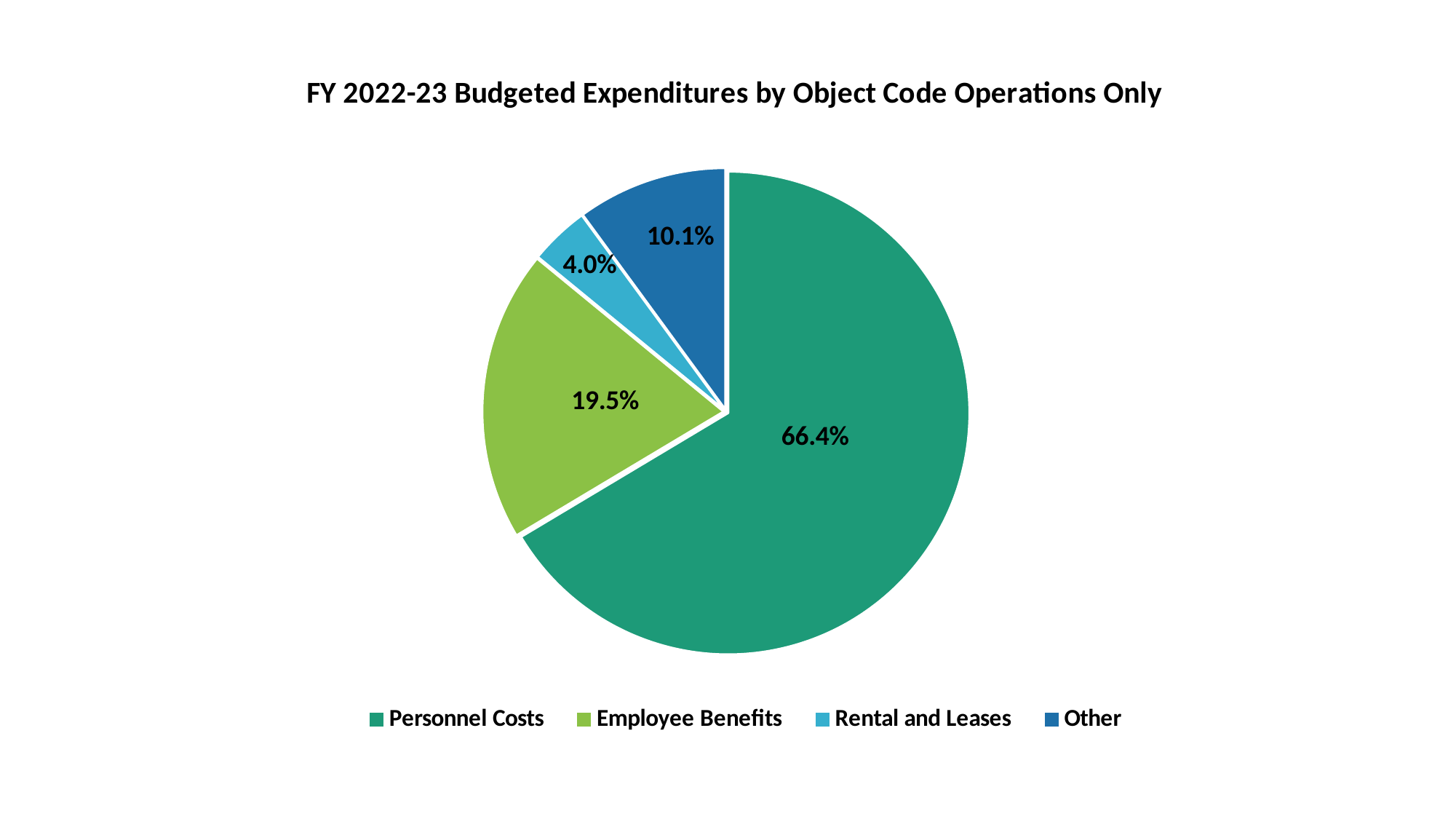
What kind of chart is shown on the slide? Pie chart What is the difference in percentage points between Other and Rental and Leases? 6.1 Which category has the largest slice of the pie? Personnel Costs What is the title of the chart? FY 2022-23 Budgeted Expenditures by Object Code Operations Only How many categories are shown in the pie chart? 4 What is the difference in percentage points between Personnel Costs and Employee Benefits? 46.9 Which is larger, the share for Employee Benefits or the share for Other? Employee Benefits What share of the pie does Personnel Costs represent? 66.4% What share of the pie does Employee Benefits represent? 19.5% What share of the pie does Other represent? 10.1% Which category has the smallest slice of the pie? Rental and Leases